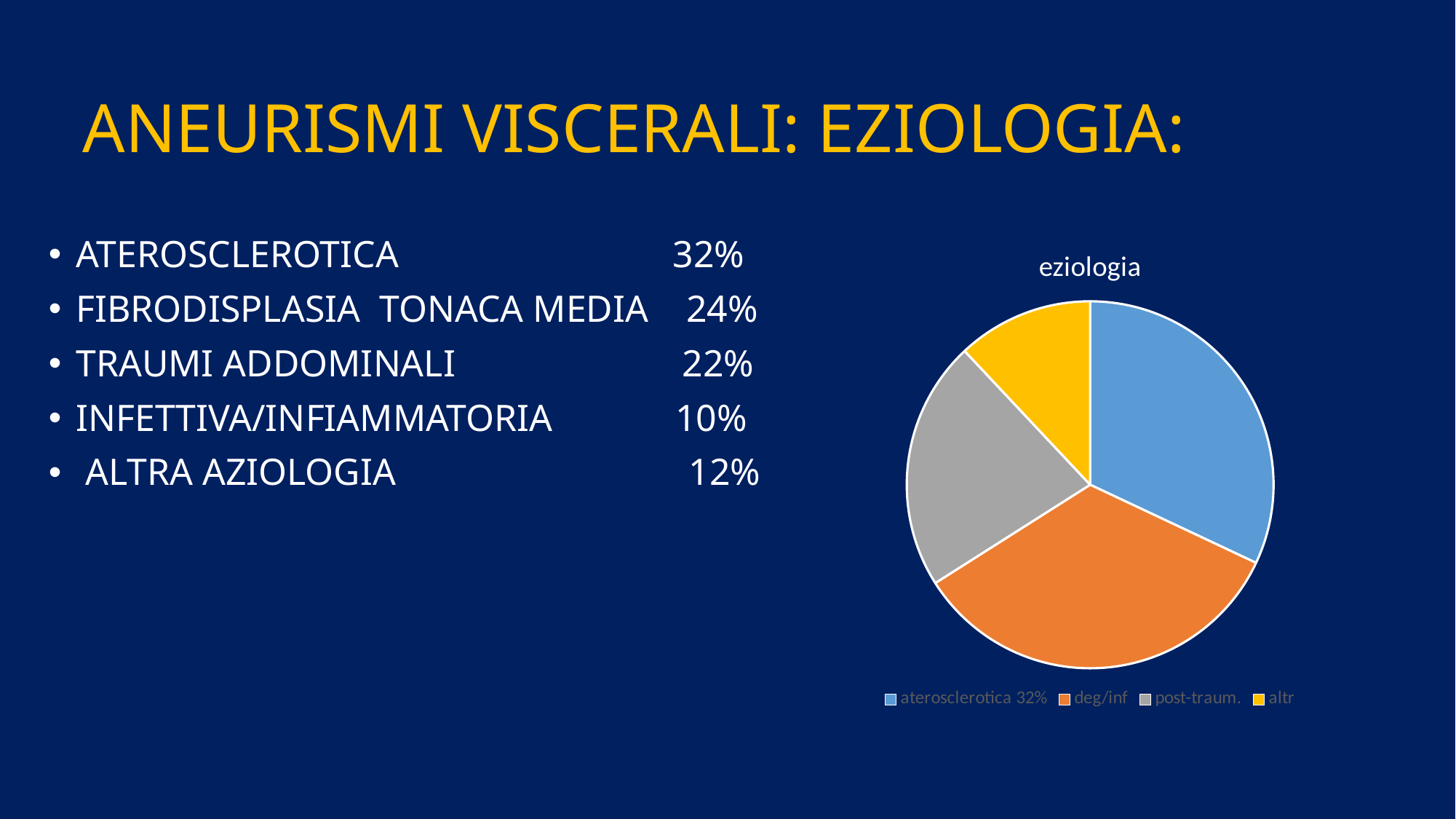
How many entries does the pie chart's legend list? 4 How many slices does the pie chart have? 4 Which slice of the pie chart is the smallest? altr Which slice is larger, aterosclerotica or altr? aterosclerotica What kind of chart is shown on the slide? pie chart What colour is the aterosclerotica slice in the pie chart? blue Which slice is larger, post-traum. or altr? post-traum. What is the title of the pie chart? eziologia What percentage does the legend give for the aterosclerotica slice? 32% Which slice is larger, deg/inf or post-traum.? deg/inf